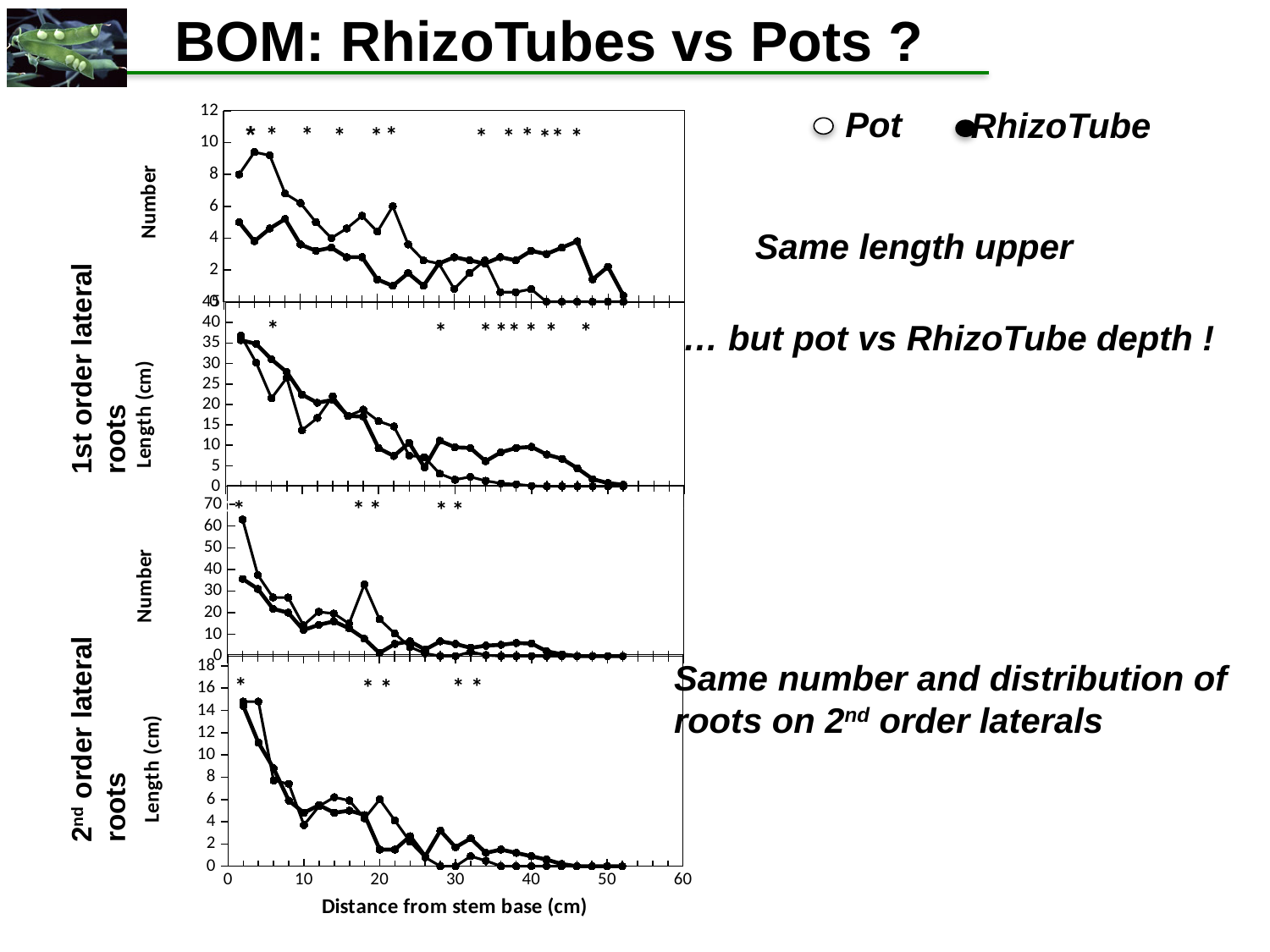
How many series does the legend list? 2 What kind of chart is the top chart (Number of 1st order lateral roots)? line chart In the bottom chart (Length (cm) of 2nd order lateral roots), do the values generally rise or fall as distance from the stem base increases? fall In the bottom chart (Length (cm) of 2nd order lateral roots), is the highest plotted value greater or less than 12? greater What are the two series named in the legend? Pot and RhizoTube In the third chart (Number of 2nd order lateral roots), is the highest plotted value greater or less than 50? greater In the top chart (Number of 1st order lateral roots), is the highest plotted value greater or less than 8? greater How many charts are stacked on the slide? 4 What is the x-axis title shared by the charts? Distance from stem base (cm) In the second chart (Length (cm) of 1st order lateral roots), do the values generally rise or fall as distance from the stem base increases? fall